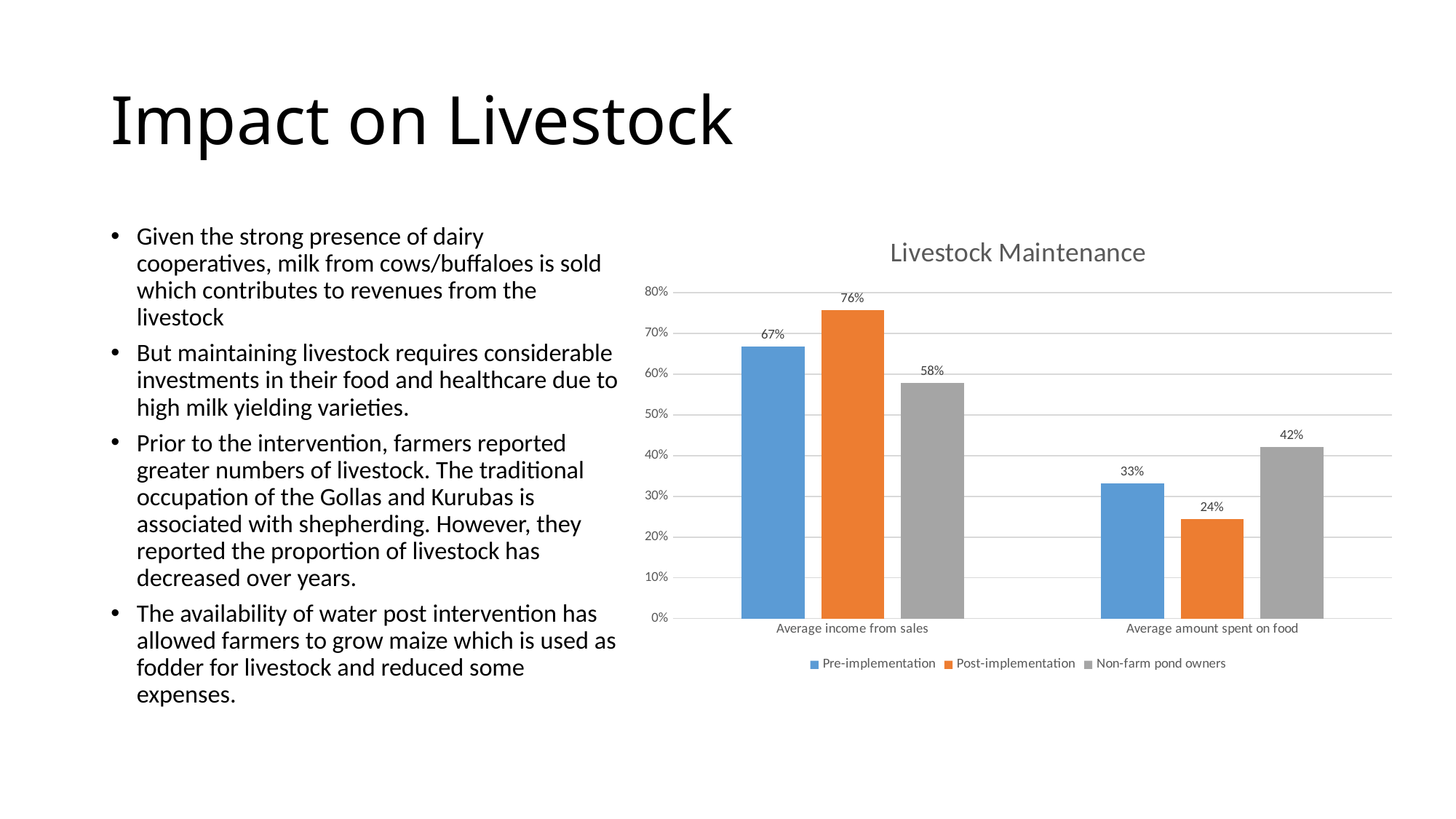
What is the difference between the Post-implementation and Pre-implementation values for Average income from sales? 9% Which series has the highest value for Average income from sales? Post-implementation What is the Post-implementation value for Average income from sales? 76% What is the Pre-implementation value for Average amount spent on food? 33% What kind of chart is shown on the slide? Bar chart How many series does the legend list? 3 Which is larger: the Pre-implementation value for Average income from sales or the Non-farm pond owners value for Average income from sales? Pre-implementation Is the Non-farm pond owners value for Average income from sales greater or less than 50%? greater What is the title of the chart? Livestock Maintenance Which series has the lowest value for Average amount spent on food? Post-implementation What is the Non-farm pond owners value for Average amount spent on food? 42% What is the difference between the Non-farm pond owners and Post-implementation values for Average amount spent on food? 18%